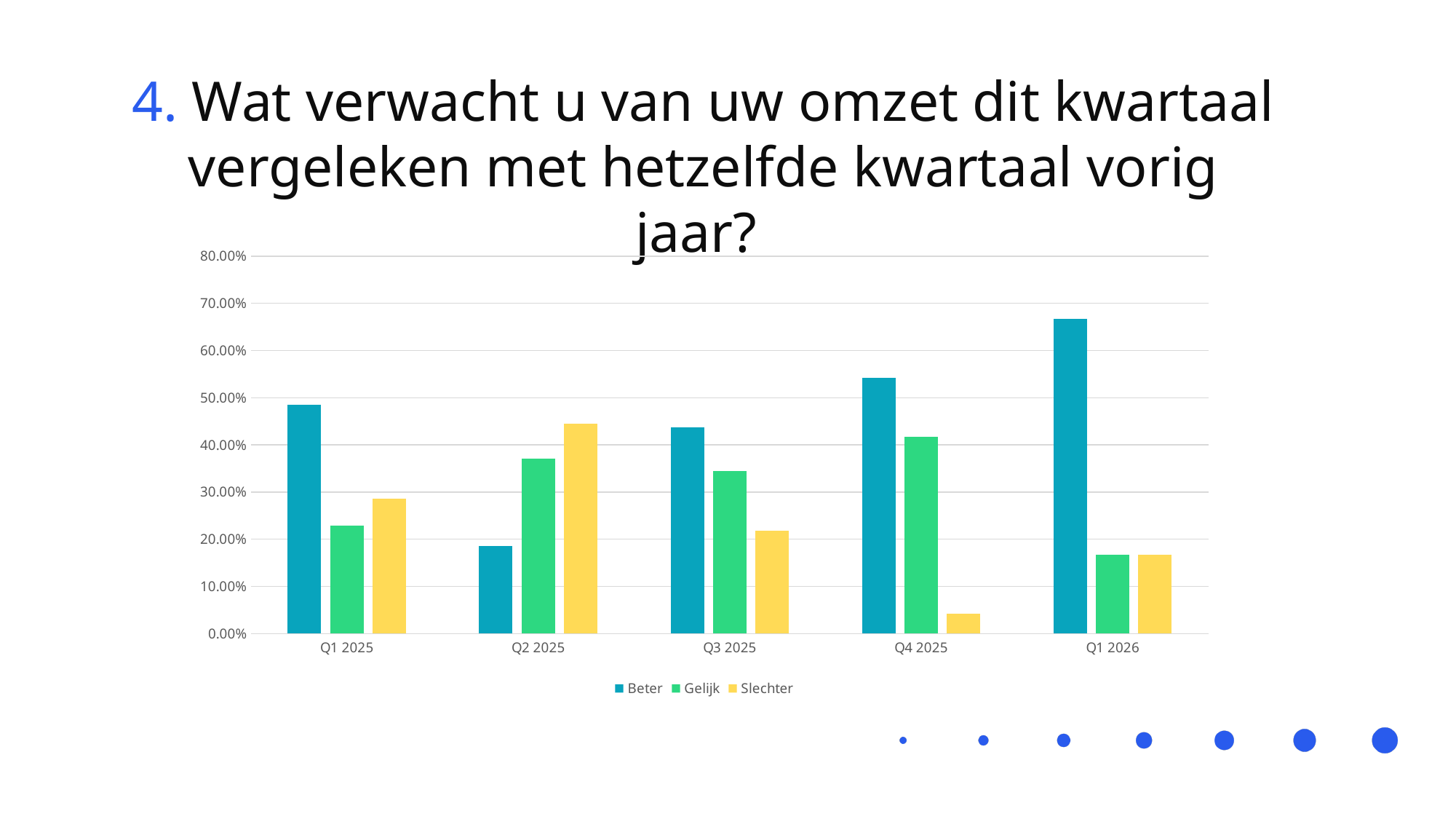
Which series are listed in the chart's legend? Beter, Gelijk, Slechter In Q2 2025, which is larger: Gelijk or Slechter? Slechter How many quarters are shown on the x axis of the chart? 5 Is the value for Slechter in Q4 2025 greater or less than 10.00%? less Is the value for Beter in Q2 2025 greater or less than 20.00%? less In which quarter is the value for Slechter the lowest? Q4 2025 In which quarter is the value for Beter the lowest? Q2 2025 What kind of chart is shown on the slide? Bar chart Does the value for Beter rise or fall from Q2 2025 to Q1 2026? Rises How many series does the chart's legend list? 3 Is the value for Beter in Q1 2026 greater or less than 60.00%? greater In which quarter is the value for Beter the highest? Q1 2026